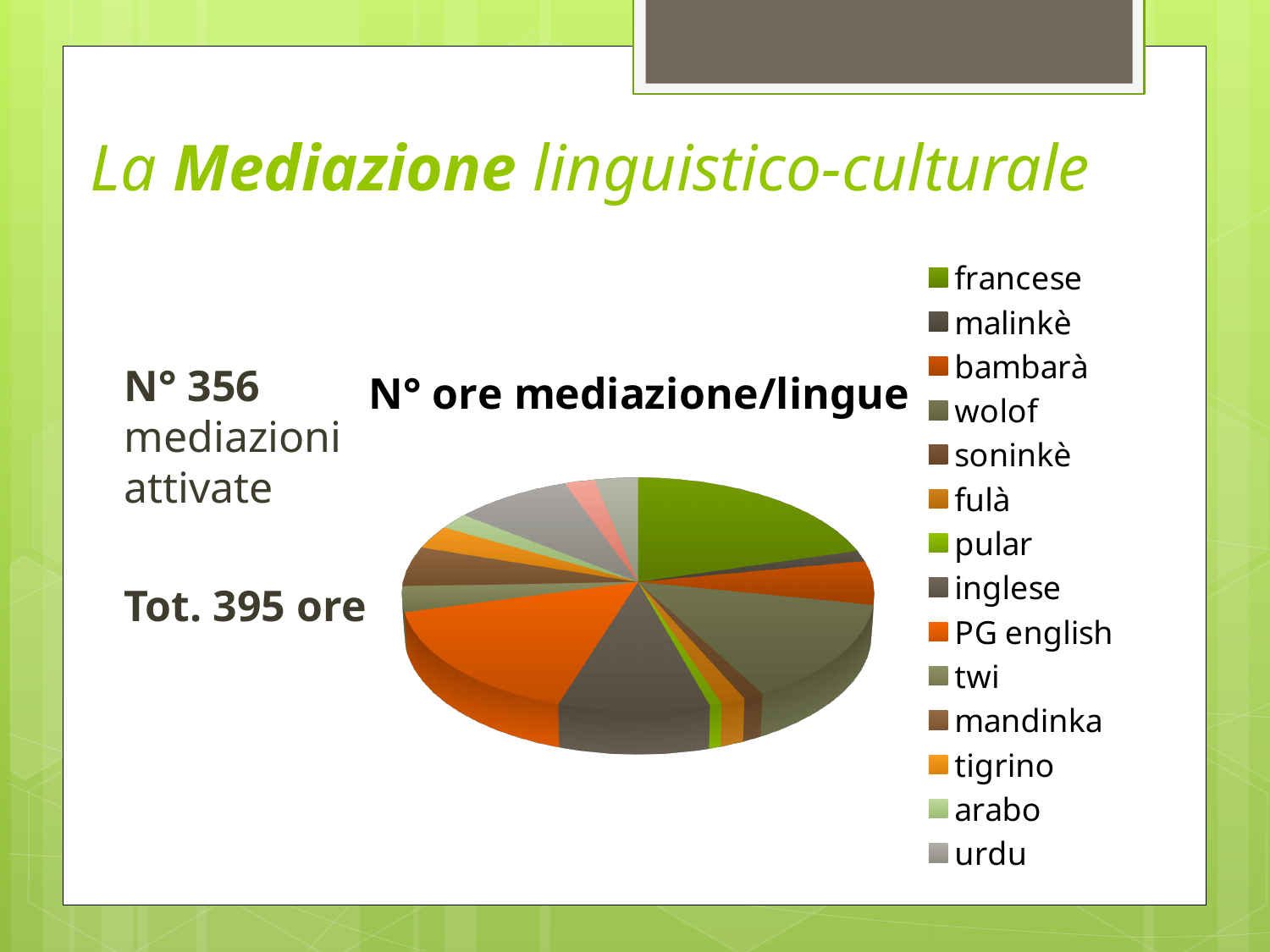
What is the title of the pie chart? N° ore mediazione/lingue Which legend entry is listed first in the pie chart's legend? francese In the pie chart, which slice is larger: inglese or soninkè? inglese In the pie chart, which slice is larger: PG english or tigrino? PG english In the pie chart, which slice is larger: wolof or pular? wolof How many entries does the legend of the pie chart list? 14 Which colour represents francese in the pie chart? green What kind of chart is shown on the slide? pie chart